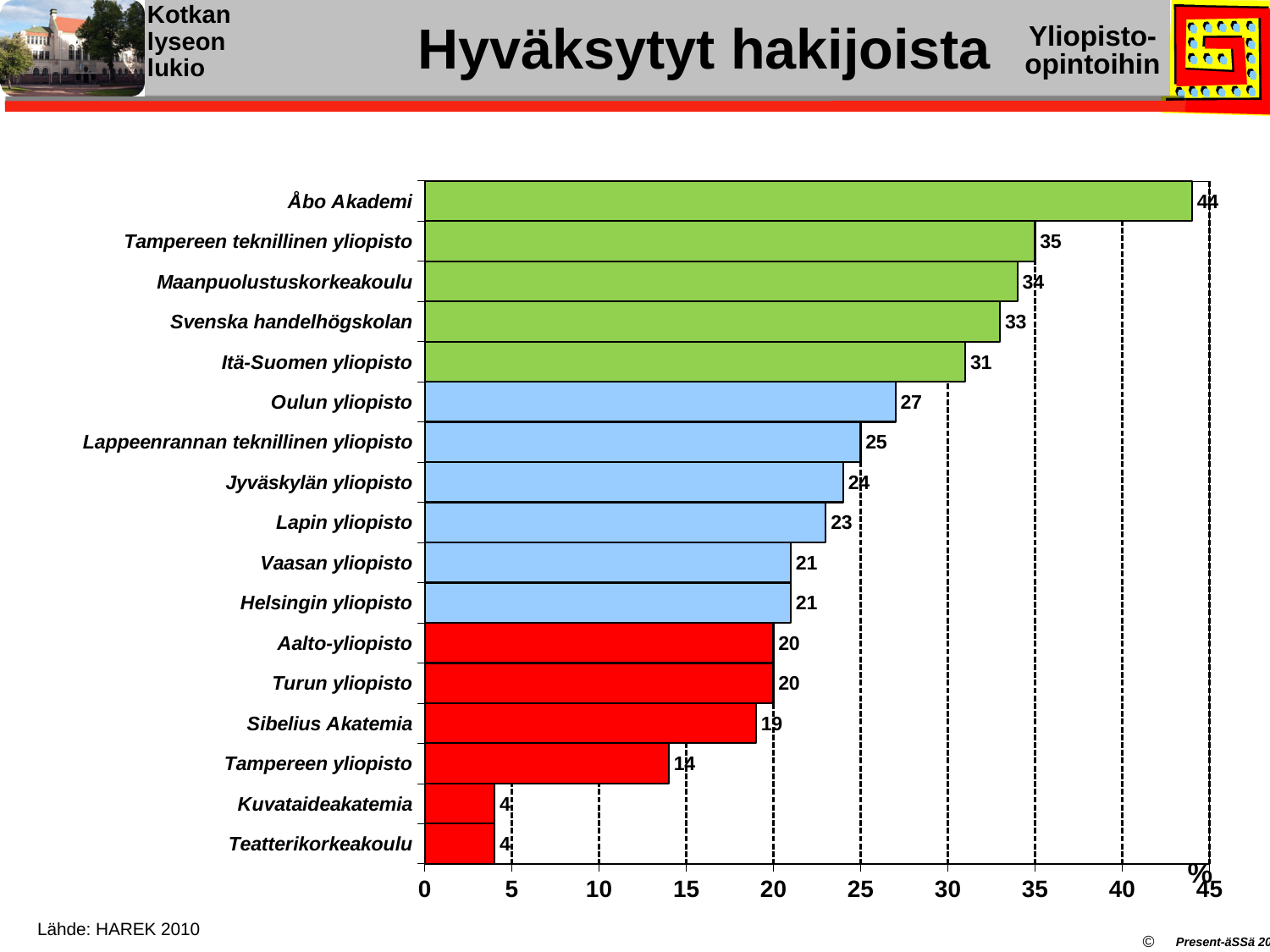
Which is larger, the value for Lappeenrannan teknillinen yliopisto or the value for Lapin yliopisto? Lappeenrannan teknillinen yliopisto How many categories are shown in the chart? 17 What is the difference between the values for Tampereen teknillinen yliopisto and Itä-Suomen yliopisto? 4 Which category has the highest value? Åbo Akademi What is the value for Tampereen yliopisto? 14 Is the value for Svenska handelhögskolan greater or less than 30? greater What is the value for Åbo Akademi? 44 What is the title of the chart? Hyväksytyt hakijoista What is the value for Oulun yliopisto? 27 What is the value for Sibelius Akatemia? 19 What kind of chart is shown on the slide? bar chart What is the difference between the values for Åbo Akademi and Teatterikorkeakoulu? 40